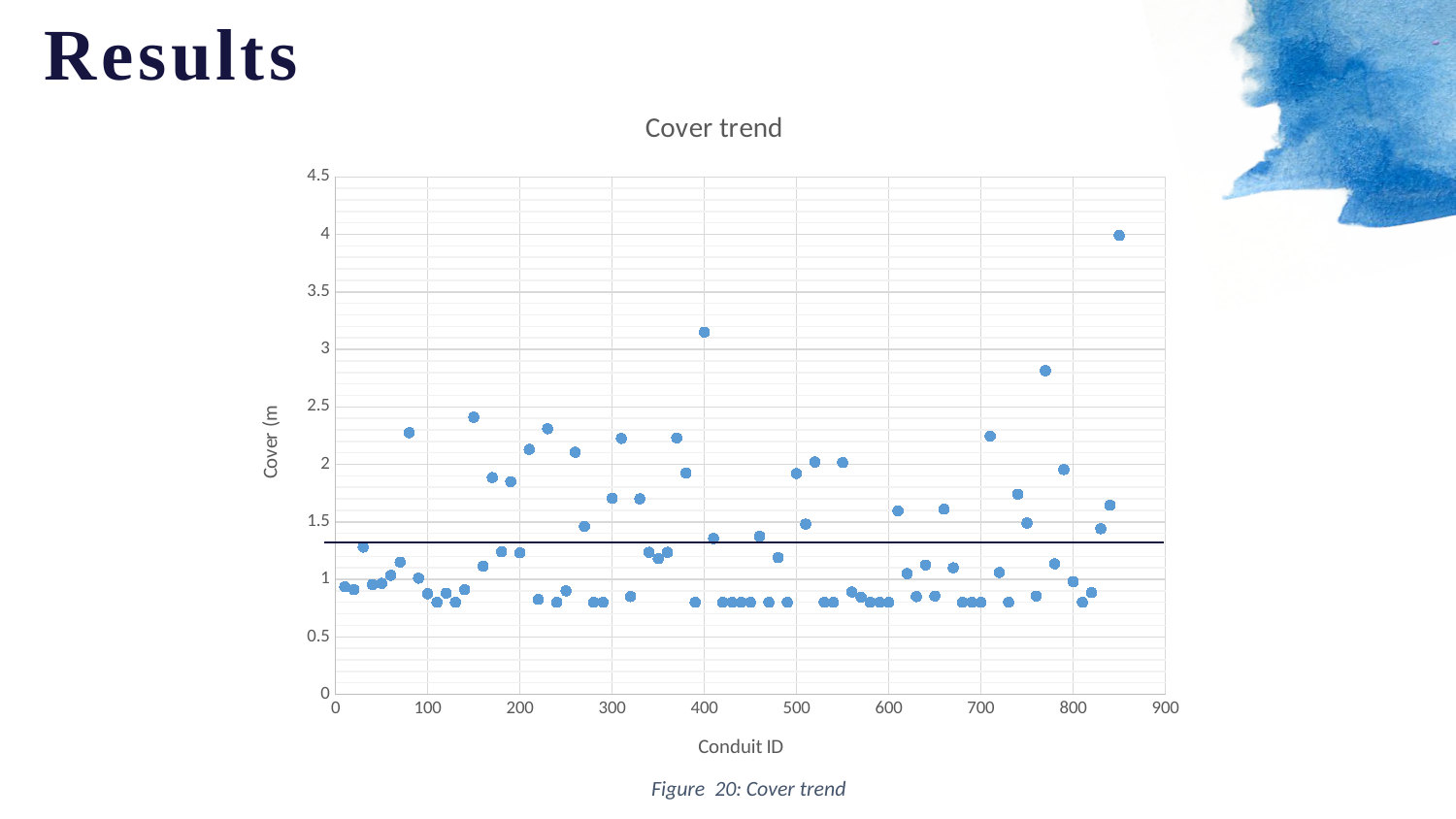
What is the label of the x axis? Conduit ID Is the highest cover value plotted greater or less than 3.5? greater Is the cover value for the point near conduit ID 400 greater or less than 3? greater What is the title of the chart? Cover trend What is the highest value shown on the x axis? 900 What kind of chart is shown on the slide? scatter chart